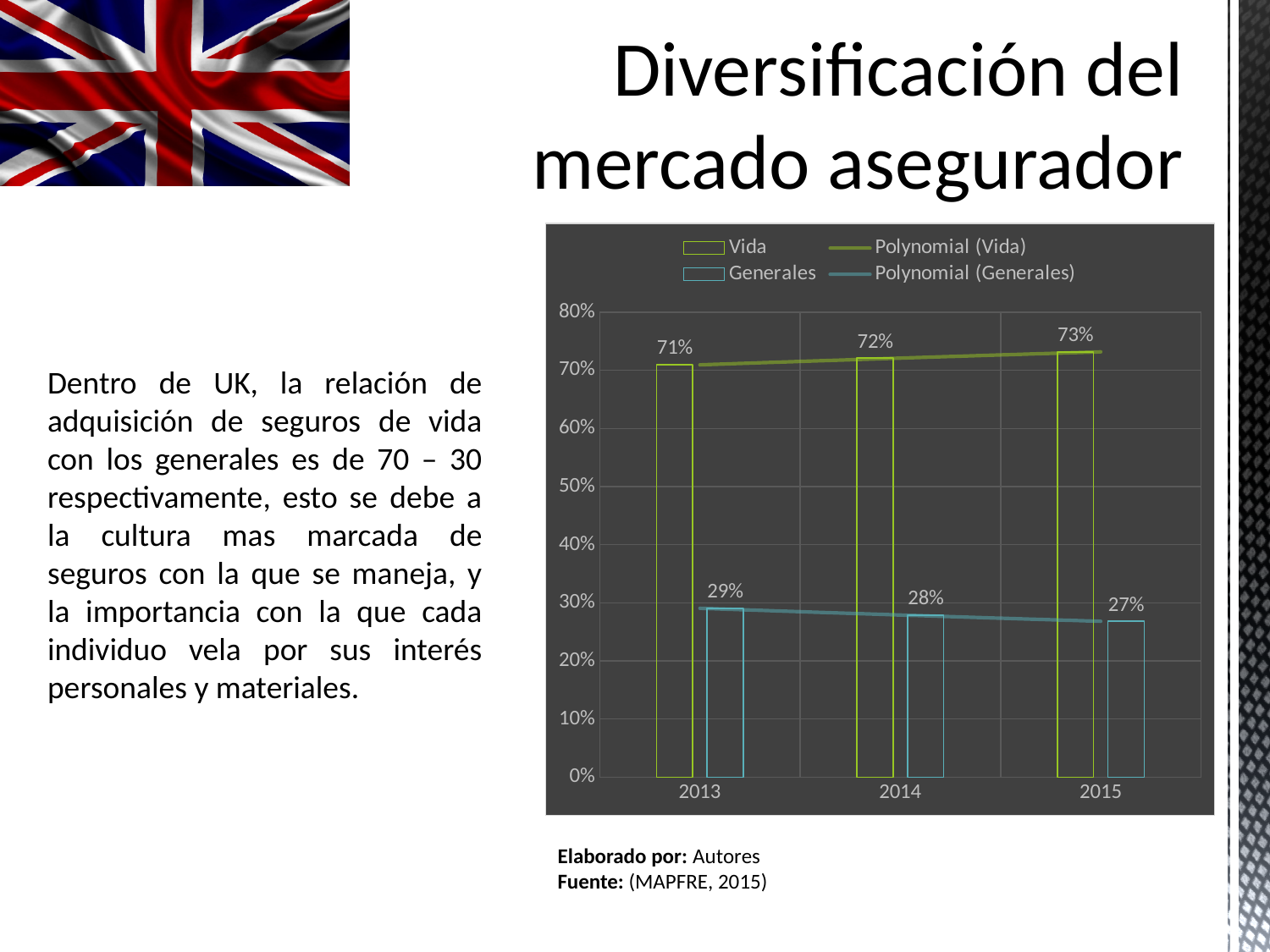
In which year is the Generales value lowest? 2015 What is the value for Generales in 2015? 27% What is the value for Generales in 2014? 28% In which year is the Vida value highest? 2015 How many years are shown on the x axis? 3 What is the value for Vida in 2015? 73% Which is larger in 2013, Vida or Generales? Vida What is the value for Vida in 2013? 71% What kind of chart is shown? Bar chart How many entries does the legend list? 4 What is the difference between the Vida and Generales values in 2014? 44% Do the Generales values rise or fall from 2013 to 2015? Fall